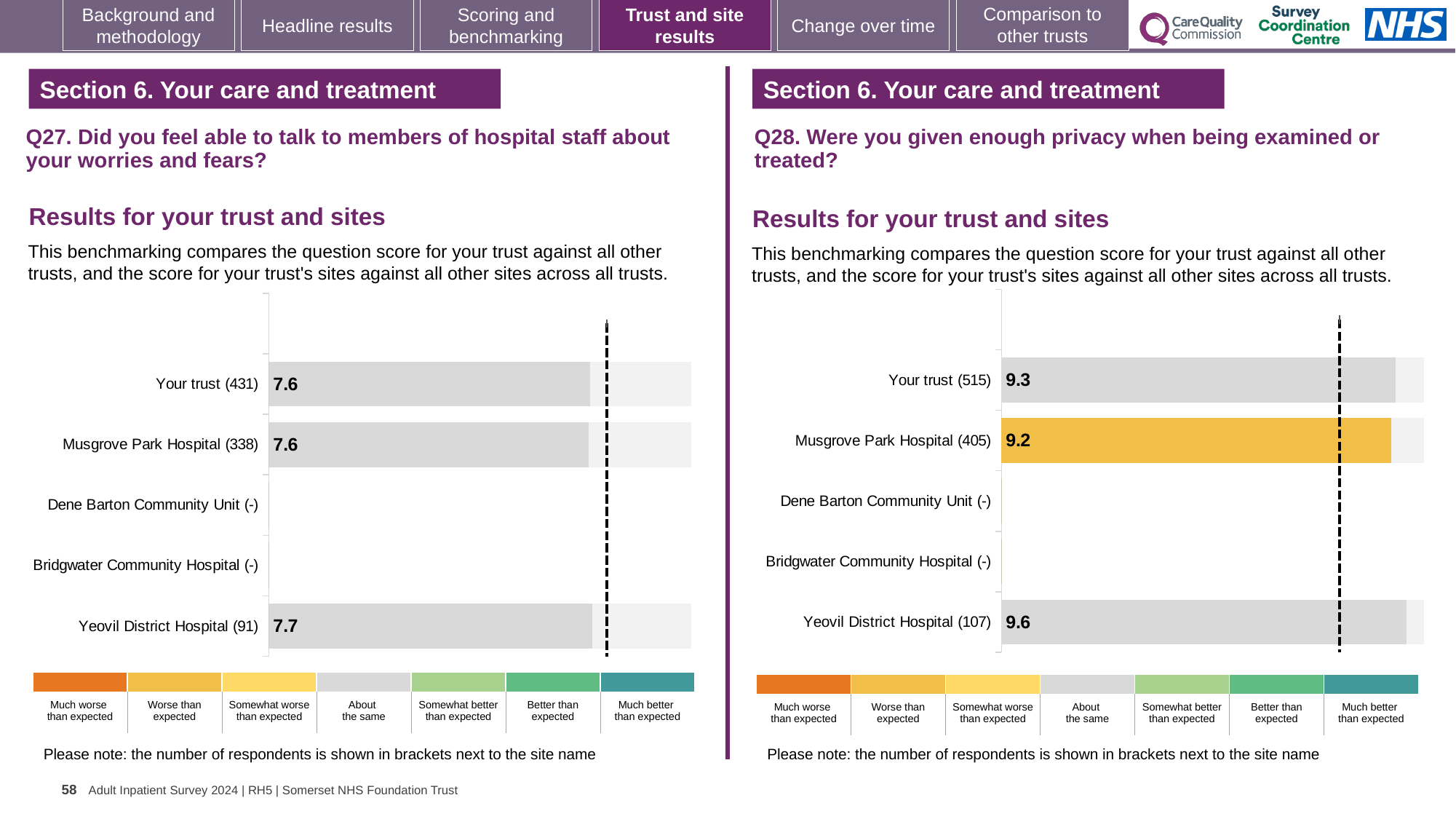
In the Q28 chart on the right, what is the difference between the scores for Yeovil District Hospital and Musgrove Park Hospital? 0.4 In the Q28 chart on the right, which site's bar is coloured yellow? Musgrove Park Hospital In the Q27 chart on the left, what is the score for Yeovil District Hospital? 7.7 What kind of chart is the Q28 chart on the right? bar chart In the Q28 chart on the right, what is the score for Musgrove Park Hospital? 9.2 In the Q28 chart on the right, which site has the highest score? Yeovil District Hospital In the Q27 chart on the left, what is the score for Your trust? 7.6 In the Q28 chart on the right, which of the scored sites has the lowest score? Musgrove Park Hospital In the Q27 chart on the left, what is the difference between the scores for Yeovil District Hospital and Your trust? 0.1 In the Q28 chart on the right, is the score for Your trust larger or smaller than the score for Musgrove Park Hospital? larger In the Q28 chart on the right, what is the score for Yeovil District Hospital? 9.6 How many site rows are listed in the Q27 chart on the left? 5